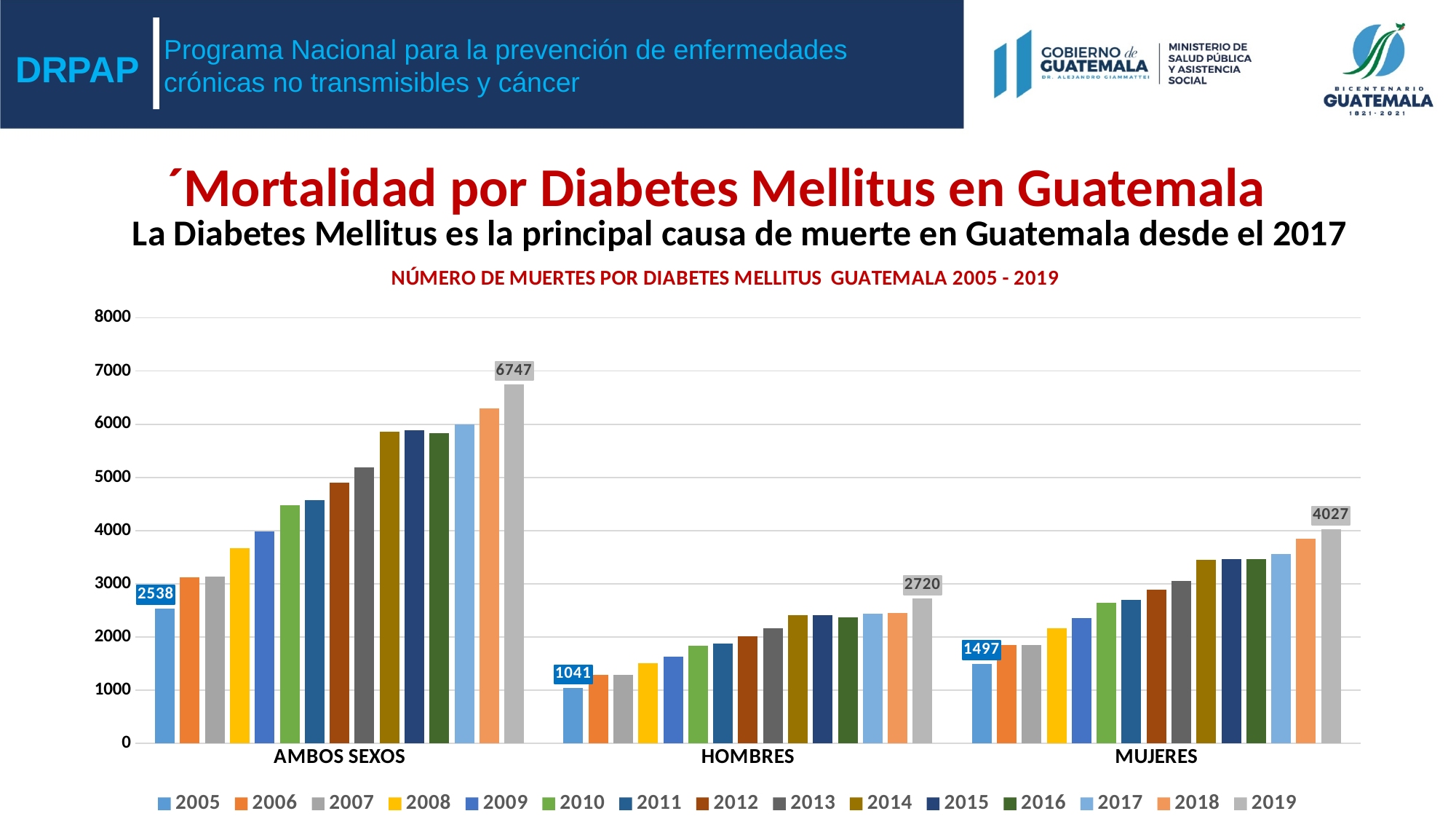
What is the value for 2019 in the HOMBRES group? 2720 How much higher is the 2019 value than the 2005 value in the AMBOS SEXOS group? 4209 How many series (years) does the legend list? 15 Within the AMBOS SEXOS group, do the values generally rise or fall from 2005 to 2019? rise What is the value for 2005 in the HOMBRES group? 1041 Is the value for 2010 in the AMBOS SEXOS group greater or less than 4000? greater How many category groups are shown on the x axis? 3 What is the value for 2005 in the MUJERES group? 1497 What is the difference between the 2019 value for MUJERES and the 2019 value for HOMBRES? 1307 What is the value for 2019 in the MUJERES group? 4027 What is the value for 2019 in the AMBOS SEXOS group? 6747 What is the value for 2005 in the AMBOS SEXOS group? 2538